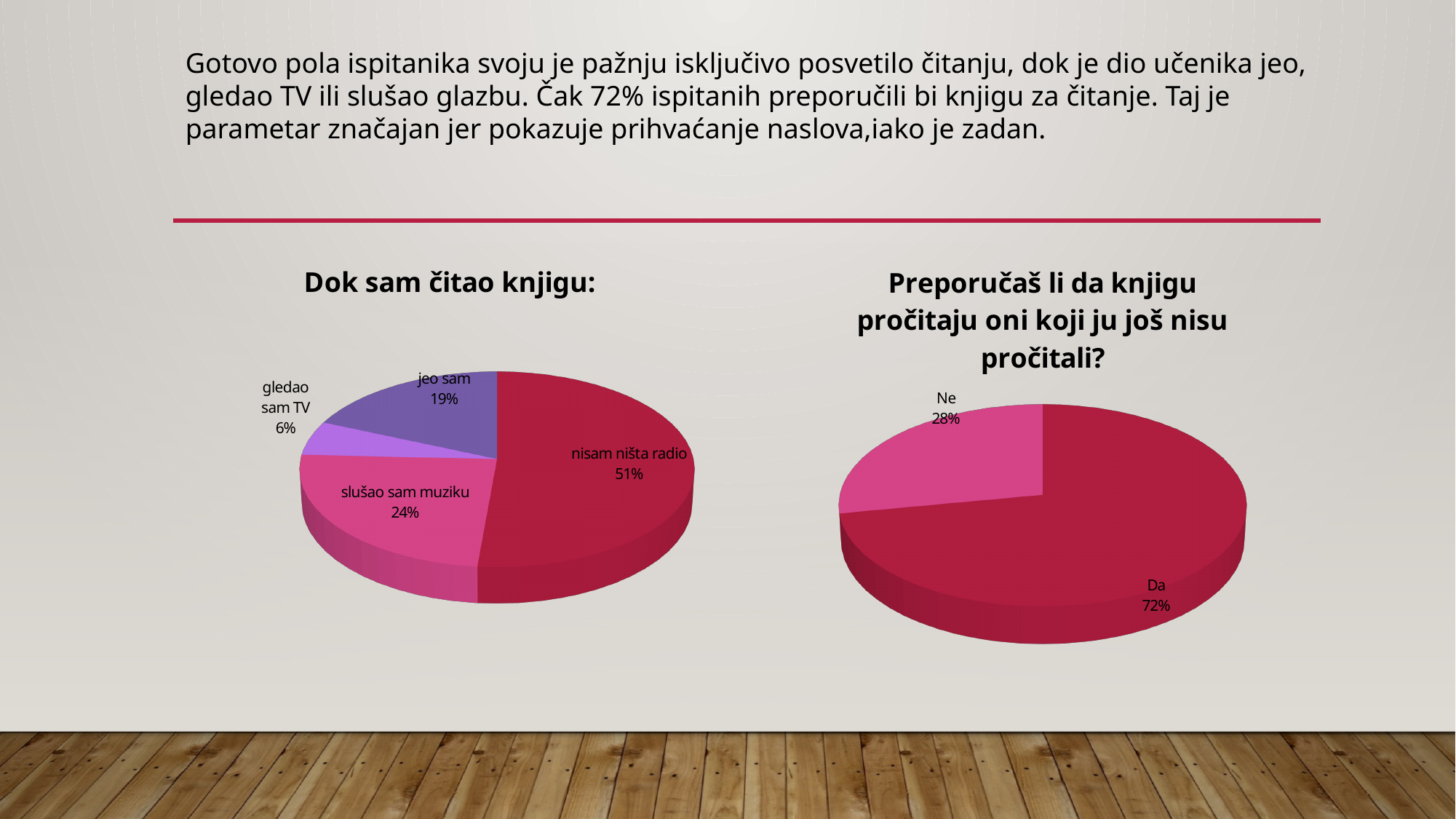
In the chart on the right, what is the difference in percentage points between 'Da' and 'Ne'? 44 In the 'Dok sam čitao knjigu:' chart, what percentage is shown for 'jeo sam'? 19% In the 'Dok sam čitao knjigu:' chart, which category has the largest slice? nisam ništa radio In the 'Dok sam čitao knjigu:' chart, which is larger: 'jeo sam' or 'gledao sam TV'? jeo sam What type of chart is used for the chart on the left? Pie chart In the 'Dok sam čitao knjigu:' chart, what is the difference in percentage points between 'slušao sam muziku' and 'jeo sam'? 5 In the 'Dok sam čitao knjigu:' chart, how many categories are shown? 4 In the 'Dok sam čitao knjigu:' chart, what percentage is shown for 'slušao sam muziku'? 24% In the 'Dok sam čitao knjigu:' chart, which category has the smallest slice? gledao sam TV In the chart on the right ('Preporučaš li da knjigu pročitaju oni koji ju još nisu pročitali?'), what percentage answered 'Da'? 72% In the chart on the right, what percentage answered 'Ne'? 28% In the 'Dok sam čitao knjigu:' chart, what share is labelled for 'nisam ništa radio'? 51%